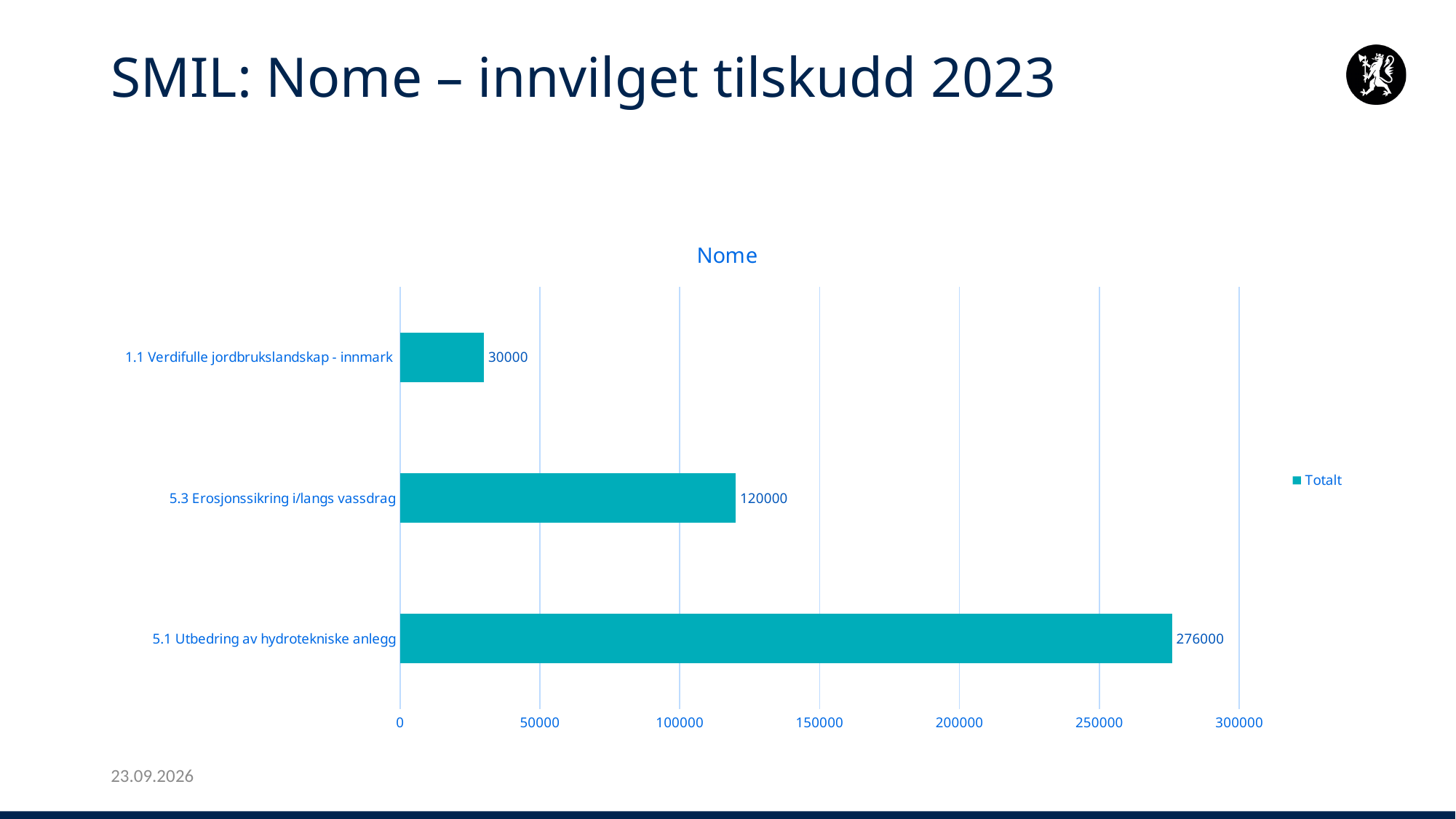
Which category has the lowest value? 1.1 Verdifulle jordbrukslandskap - innmark What kind of chart is shown on the slide? bar chart Which is larger: the value for 5.3 Erosjonssikring i/langs vassdrag or the value for 1.1 Verdifulle jordbrukslandskap - innmark? 5.3 Erosjonssikring i/langs vassdrag What is the value for 5.3 Erosjonssikring i/langs vassdrag? 120000 How many categories are shown in the chart? 3 How many series does the legend list? 1 What is the value for 1.1 Verdifulle jordbrukslandskap - innmark? 30000 What is the value for 5.1 Utbedring av hydrotekniske anlegg? 276000 Which category has the highest value? 5.1 Utbedring av hydrotekniske anlegg What is the difference between the values for 5.1 Utbedring av hydrotekniske anlegg and 5.3 Erosjonssikring i/langs vassdrag? 156000 Is the value for 5.1 Utbedring av hydrotekniske anlegg greater or less than 250000? greater What is the difference between the values for 5.3 Erosjonssikring i/langs vassdrag and 1.1 Verdifulle jordbrukslandskap - innmark? 90000